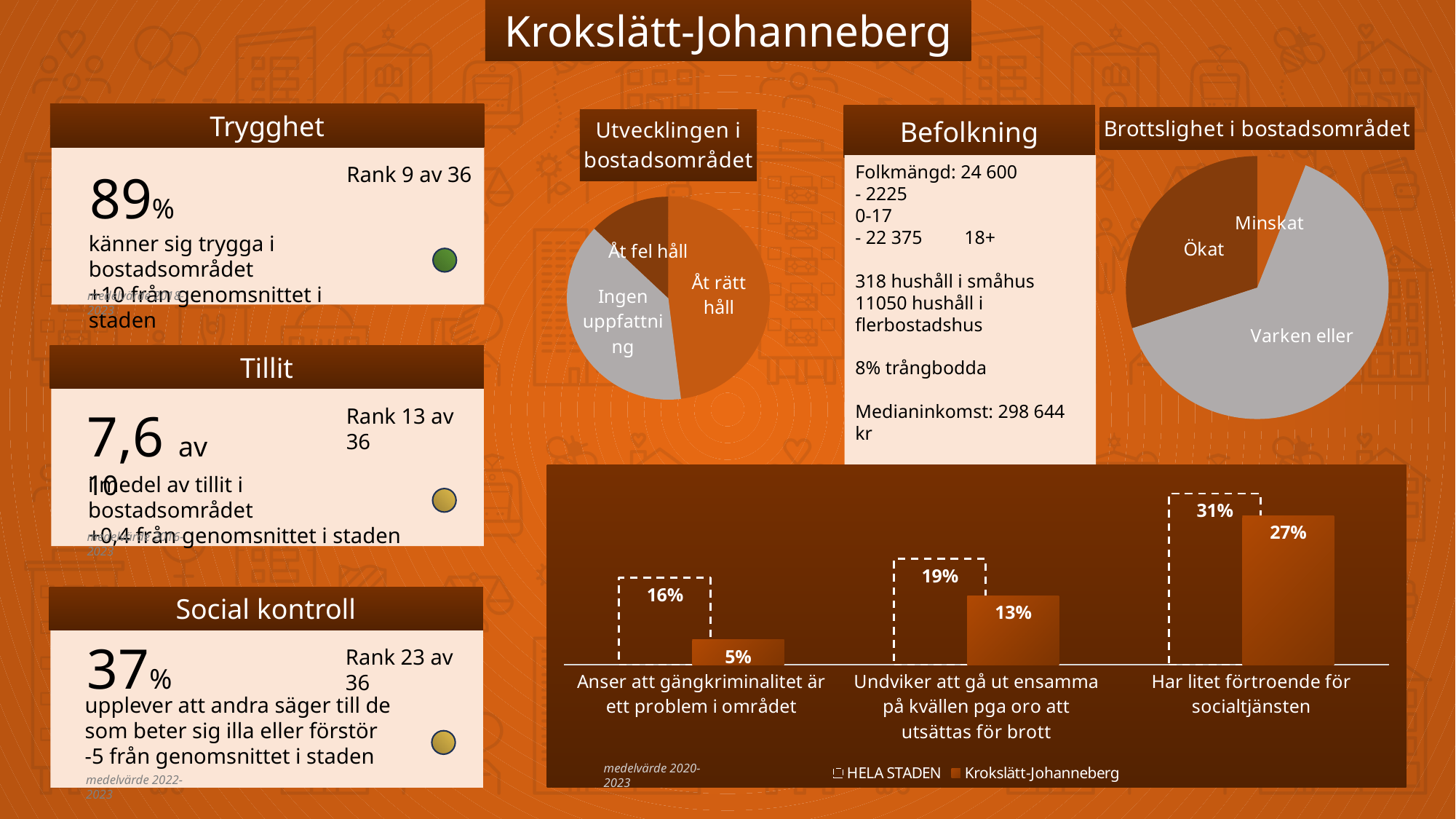
In the bar chart at the bottom of the slide, what is the value for HELA STADEN for 'Har litet förtroende för socialtjänsten'? 31% How many series does the legend of the bar chart at the bottom of the slide list? 2 In the bar chart at the bottom of the slide, which category has the highest value for Krokslätt-Johanneberg? Har litet förtroende för socialtjänsten In the bar chart at the bottom of the slide, what is the value for Krokslätt-Johanneberg for 'Anser att gängkriminalitet är ett problem i området'? 5% In the bar chart at the bottom of the slide, what is the value for Krokslätt-Johanneberg for 'Undviker att gå ut ensamma på kvällen pga oro att utsättas för brott'? 13% What kind of chart is 'Brottslighet i bostadsområdet'? Pie chart In the pie chart 'Utvecklingen i bostadsområdet', which slice is the smallest? Åt fel håll In the bar chart at the bottom of the slide, which is larger for 'Undviker att gå ut ensamma på kvällen pga oro att utsättas för brott': HELA STADEN or Krokslätt-Johanneberg? HELA STADEN In the bar chart at the bottom of the slide, which category has the lowest value for HELA STADEN? Anser att gängkriminalitet är ett problem i området How many categories are shown in the bar chart at the bottom of the slide? 3 In the pie chart 'Brottslighet i bostadsområdet', which slice is the largest? Varken eller In the bar chart at the bottom of the slide, what is the difference between HELA STADEN and Krokslätt-Johanneberg for 'Anser att gängkriminalitet är ett problem i området'? 11%